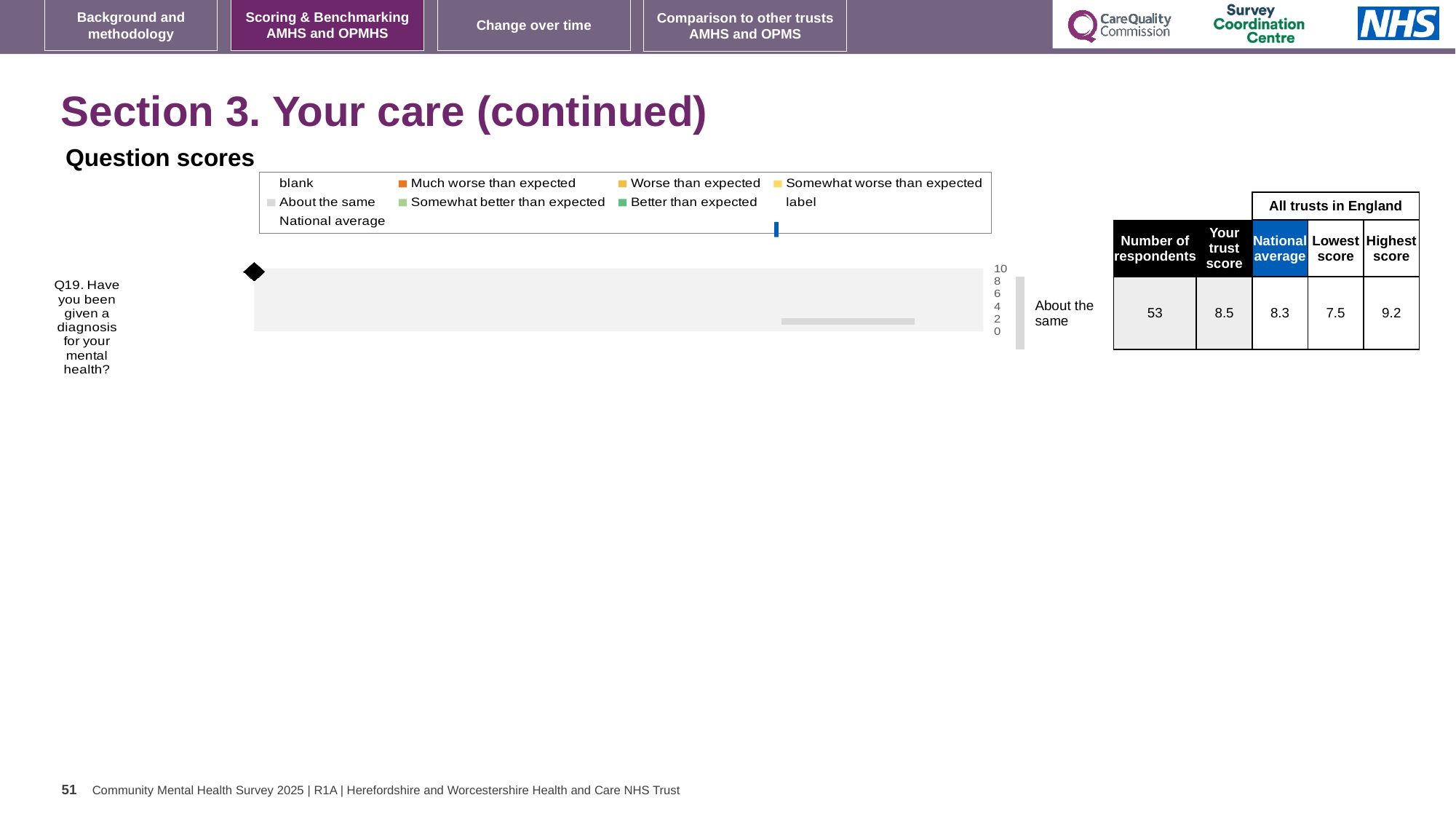
What kind of chart is used to show the Q19 question score? bar chart In the table beside the chart, what is the trust's score for Q19? 8.5 In the table beside the chart, what is the national average score for Q19? 8.3 For Q19, which is larger: the trust's score or the national average? the trust's score What colour is used in the legend for 'Much worse than expected'? orange How many survey questions are plotted on the chart? 1 In the table beside the chart, what is the highest score among all trusts in England for Q19? 9.2 For Q19, what is the difference between the highest score and the lowest score among all trusts in England? 1.7 What benchmark category label is shown next to the bar for Q19? About the same In the table beside the chart, what is the lowest score among all trusts in England for Q19? 7.5 Which question is plotted on the chart? Q19. Have you been given a diagnosis for your mental health? In the table beside the chart, how many respondents answered Q19? 53